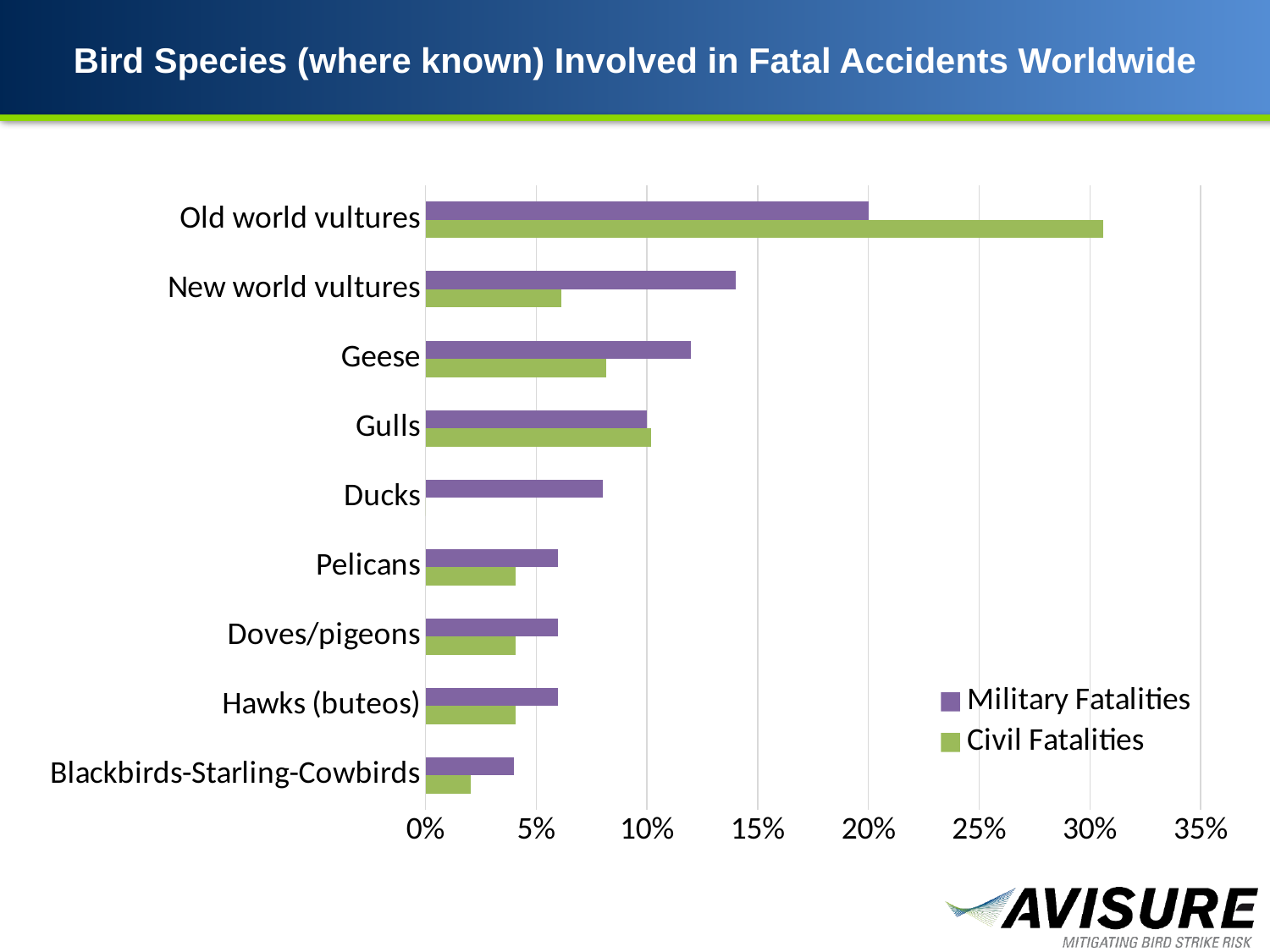
What colour represents Civil Fatalities in the legend? green Is the Military Fatalities value for New world vultures greater or less than 15%? less Which bird species has the highest Civil Fatalities value? Old world vultures Is the Civil Fatalities value for Old world vultures greater or less than 25%? greater What kind of chart is shown on the slide? bar chart For Geese, which is larger: Military Fatalities or Civil Fatalities? Military Fatalities Which bird species has the highest Military Fatalities value? Old world vultures Which has the larger Military Fatalities value: New world vultures or Geese? New world vultures Is the Military Fatalities value for Ducks greater or less than 5%? greater How many bird species categories are plotted on the chart? 9 How many series does the legend list? 2 Which bird species has the lowest Military Fatalities value? Blackbirds-Starling-Cowbirds